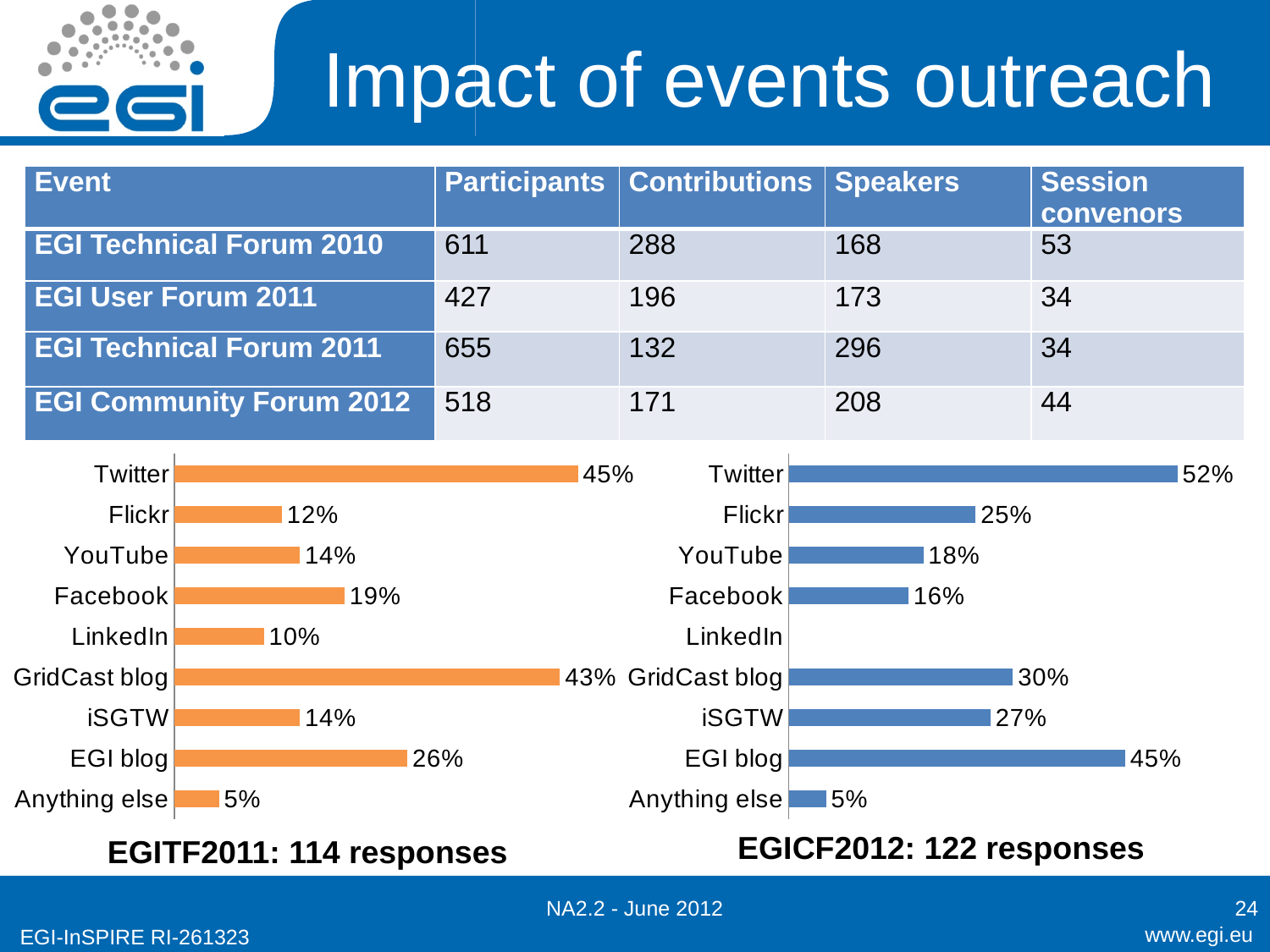
In the right chart (EGICF2012: 122 responses), what is the value for EGI blog? 45% In the right chart (EGICF2012: 122 responses), what is the difference between the values for Twitter and Flickr? 27% What type of chart is the right chart (EGICF2012: 122 responses)? Bar chart In the left chart (EGITF2011: 114 responses), what is the value for GridCast blog? 43% In the left chart (EGITF2011: 114 responses), which category has the lowest value? Anything else What colour are the bars in the left chart (EGITF2011: 114 responses)? Orange How many categories are listed on the left chart (EGITF2011: 114 responses)? 9 In the right chart (EGICF2012: 122 responses), which category has the highest value? Twitter In the left chart (EGITF2011: 114 responses), what is the difference between the values for EGI blog and Facebook? 7% In the left chart (EGITF2011: 114 responses), what is the value for Twitter? 45% In the left chart (EGITF2011: 114 responses), which is larger, the value for Facebook or the value for Flickr? Facebook In the right chart (EGICF2012: 122 responses), which is larger, the value for GridCast blog or the value for iSGTW? GridCast blog